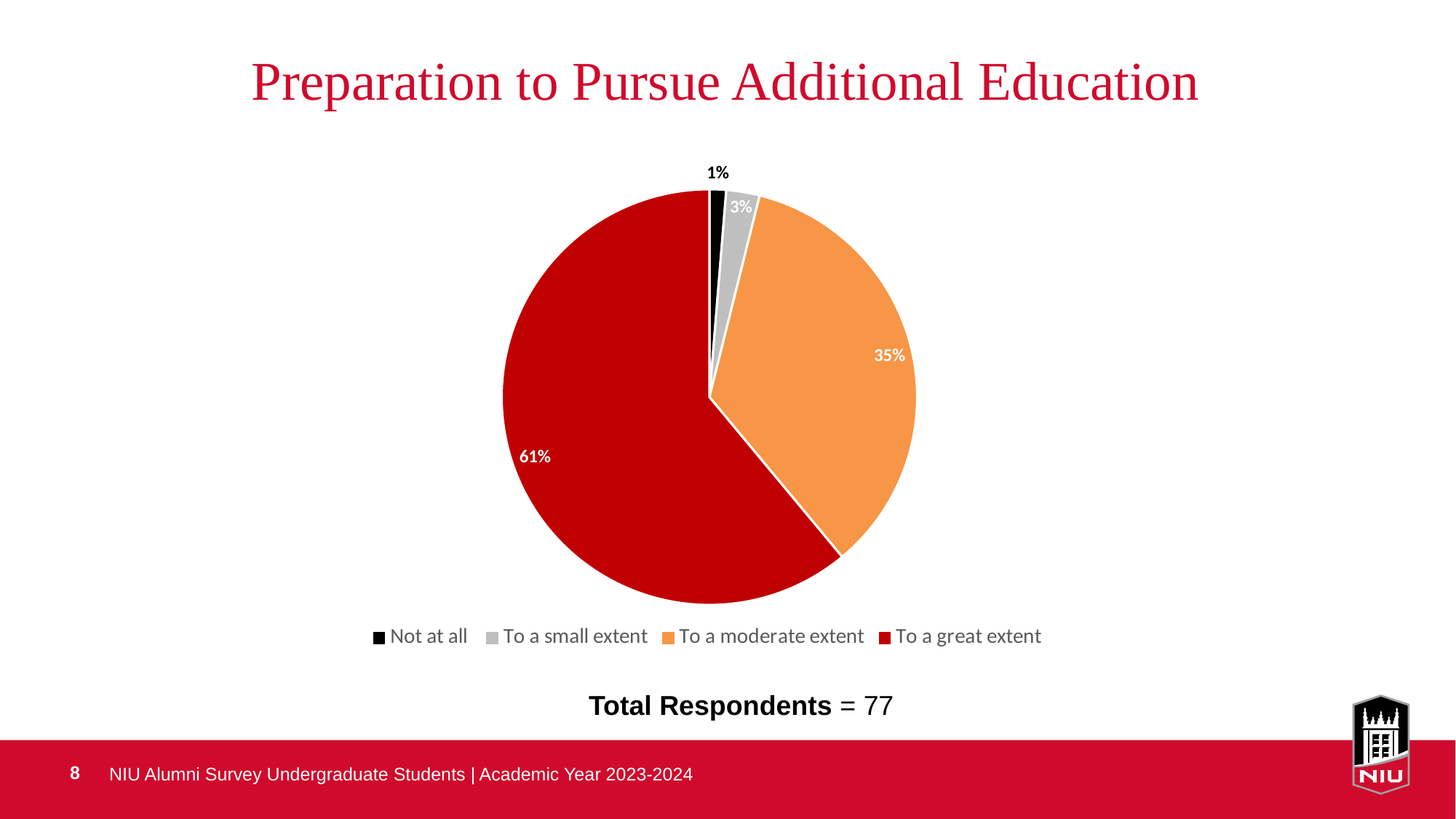
What percentage of respondents answered "To a moderate extent"? 35% What colour is the slice for "To a moderate extent"? Orange What percentage of respondents answered "Not at all"? 1% What percentage of respondents answered "To a small extent"? 3% Which is larger: the share for "To a moderate extent" or the share for "To a small extent"? To a moderate extent Which response category has the smallest share of the pie? Not at all Which response category has the largest share of the pie? To a great extent What is the title of the chart on the slide? Preparation to Pursue Additional Education What type of chart is shown on the slide? Pie chart What is the difference in percentage points between "To a great extent" and "To a moderate extent"? 26 What percentage of respondents answered "To a great extent"? 61% How many categories does the legend list? 4